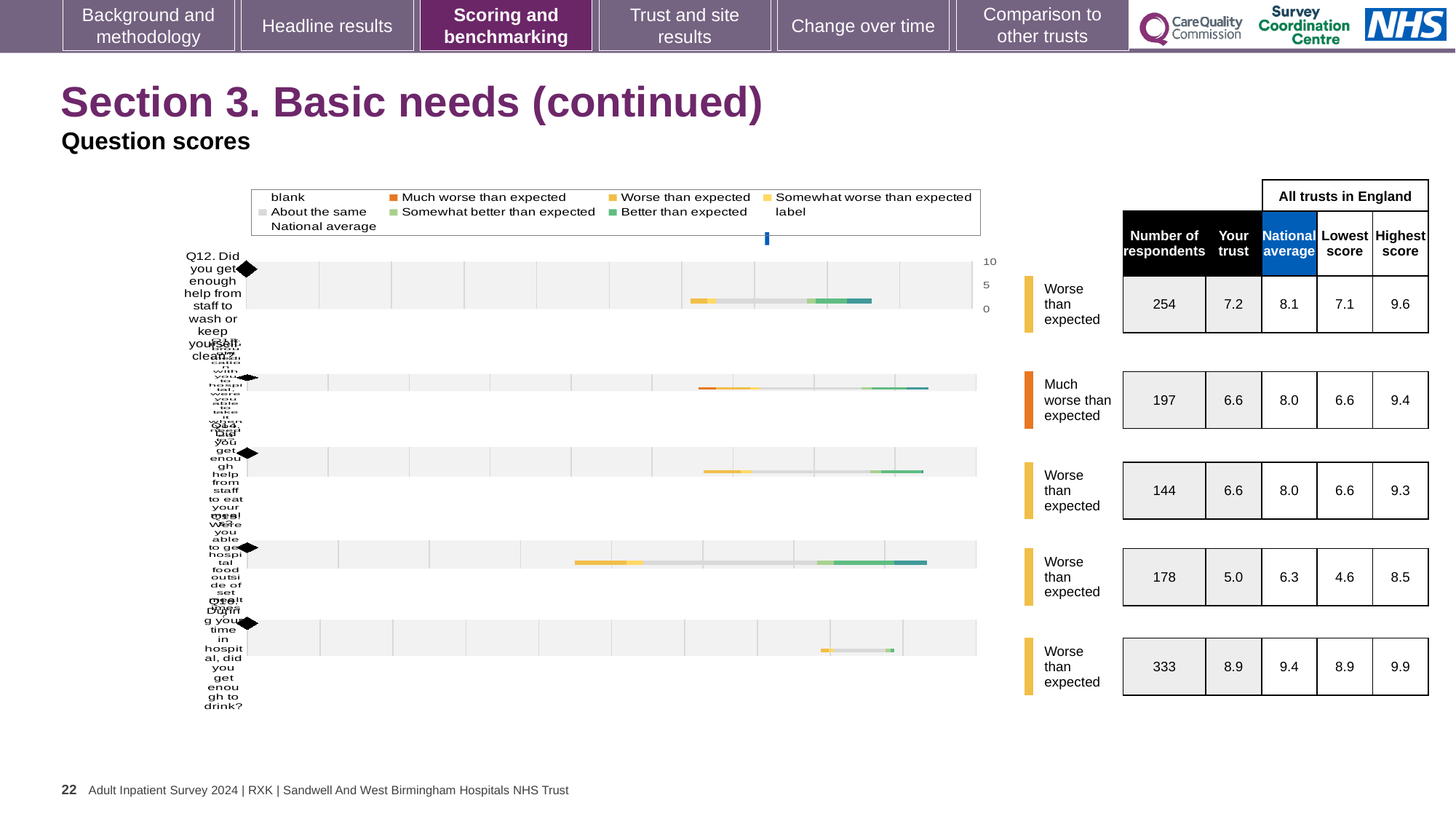
Which chart row has the lowest 'Your trust' score in the table? the fourth row, 5.0 Which chart row is labelled 'Much worse than expected'? the second row Which chart row has the highest 'Your trust' score in the table? the fifth (bottom) row, 8.9 Is the 'Your trust' score for the first chart row (7.2) larger or smaller than that for the second chart row (6.6)? larger In the table beside the first chart (Q12), what is the National average score? 8.1 In the table beside the first chart (Q12, help from staff to wash or keep yourself clean), what is the 'Your trust' score? 7.2 In the table beside the fourth chart from the top, how many respondents are listed? 178 What kind of chart is used for the Q12 question score on the slide? bar chart In the table beside the fifth (bottom) chart, what is the Highest score for all trusts in England? 9.9 For the first chart (Q12), what is the difference between the National average (8.1) and the 'Your trust' score (7.2)? 0.9 What colour does the legend use for 'Much worse than expected'? orange How many question-score charts (rows) are shown on the slide? 5